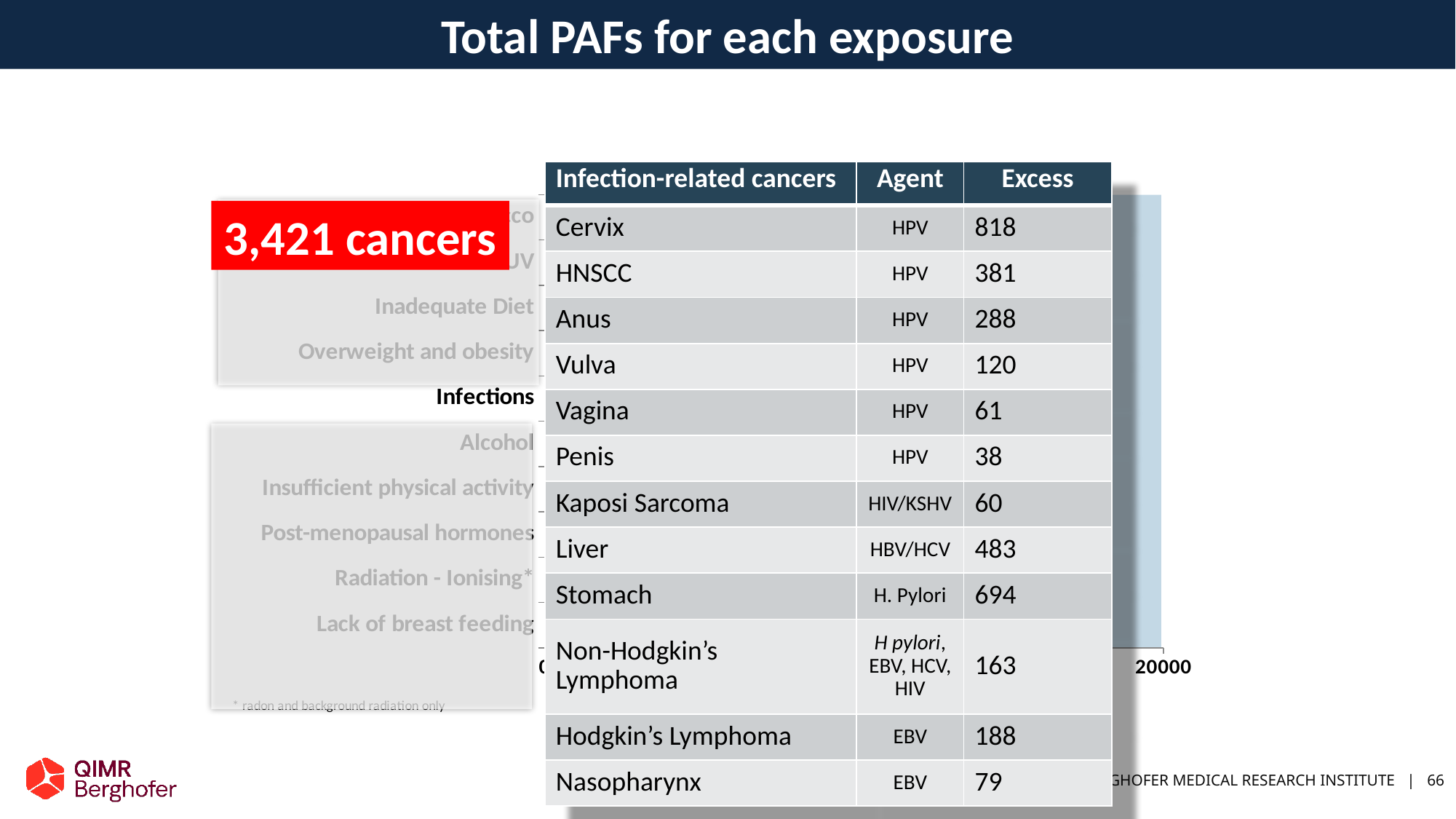
What number of cancers is stated in the red callout box on the chart? 3,421 cancers What kind of chart is partially visible behind the table on the slide? bar chart What is the title of the chart on the slide? Total PAFs for each exposure Which exposure category on the chart is shown in bold, next to the red callout? Infections What is the largest value shown on the chart's horizontal axis? 20000